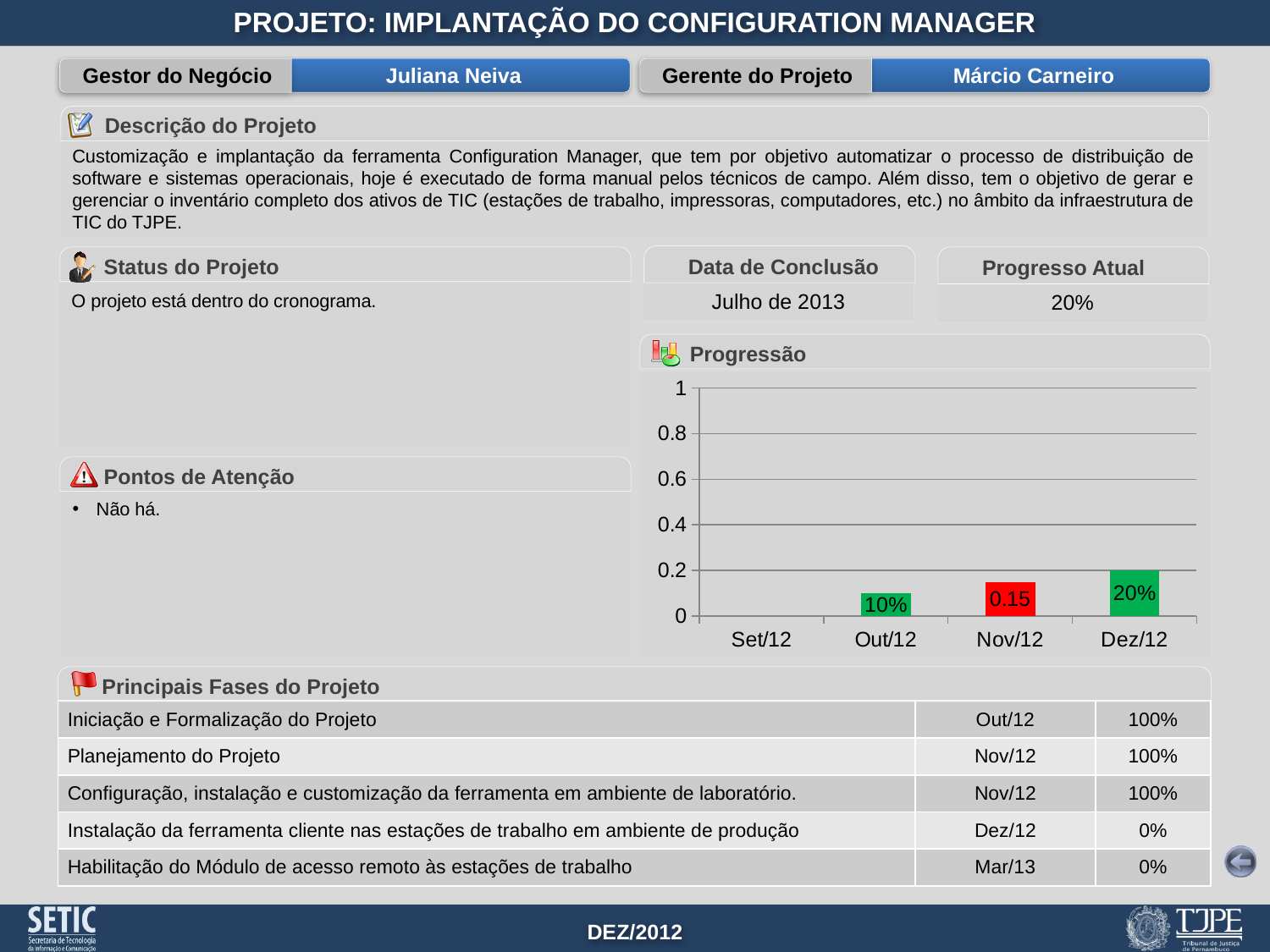
How many months are shown on the x axis of the Progressão chart? 4 Which month has the highest value in the Progressão chart? Dez/12 What kind of chart is the Progressão chart? bar chart What colour is the Nov/12 bar in the Progressão chart? red What is the difference between the Dez/12 and Out/12 values in the Progressão chart? 10% What is the value shown for Out/12 in the Progressão chart? 10% Do the values in the Progressão chart rise or fall from Out/12 to Dez/12? rise What is the value shown for Dez/12 in the Progressão chart? 20% Is the value for Dez/12 in the Progressão chart greater or less than 0.4? less In the Progressão chart, which is larger, the value for Nov/12 or the value for Dez/12? Dez/12 What is the title of the chart on the slide? Progressão What is the value shown for Nov/12 in the Progressão chart? 0.15